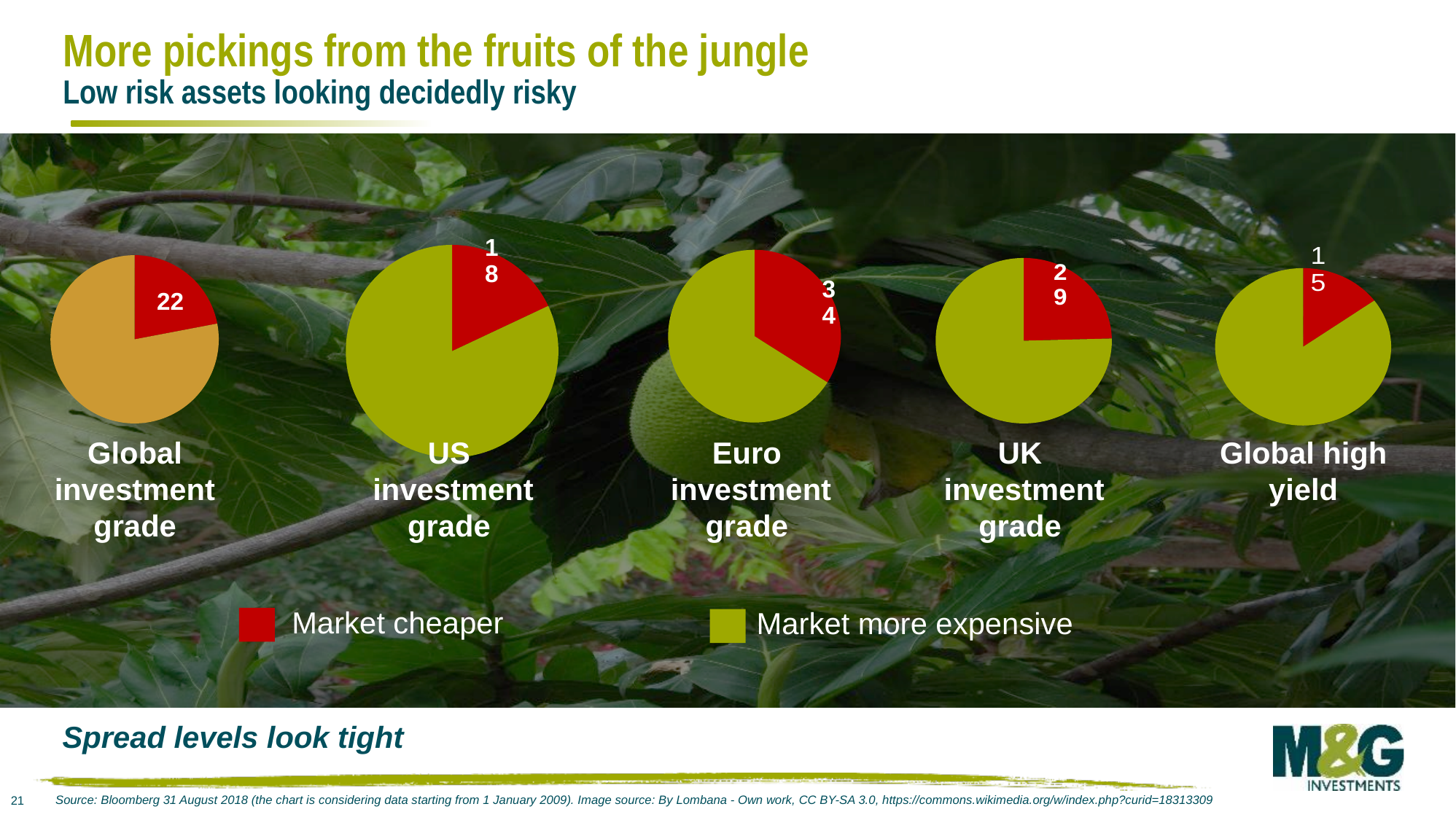
How many entries does the legend list? 2 Which has a larger red slice value, the UK investment grade pie chart or the Global investment grade pie chart? UK investment grade What value is shown on the red slice of the Global high yield pie chart? 15 How many pie charts are shown on the slide? 5 What is the difference between the red slice values of the Euro investment grade and Global high yield pie charts? 19 What value is shown on the red slice of the Global investment grade pie chart? 22 Which of the five pie charts has the largest red 'Market cheaper' value? Euro investment grade What value is shown on the red slice of the US investment grade pie chart? 18 Which of the five pie charts has the smallest red 'Market cheaper' value? Global high yield What value is shown on the red slice of the Euro investment grade pie chart? 34 What kind of charts are shown on the slide? Pie charts What value is shown on the red slice of the UK investment grade pie chart? 29